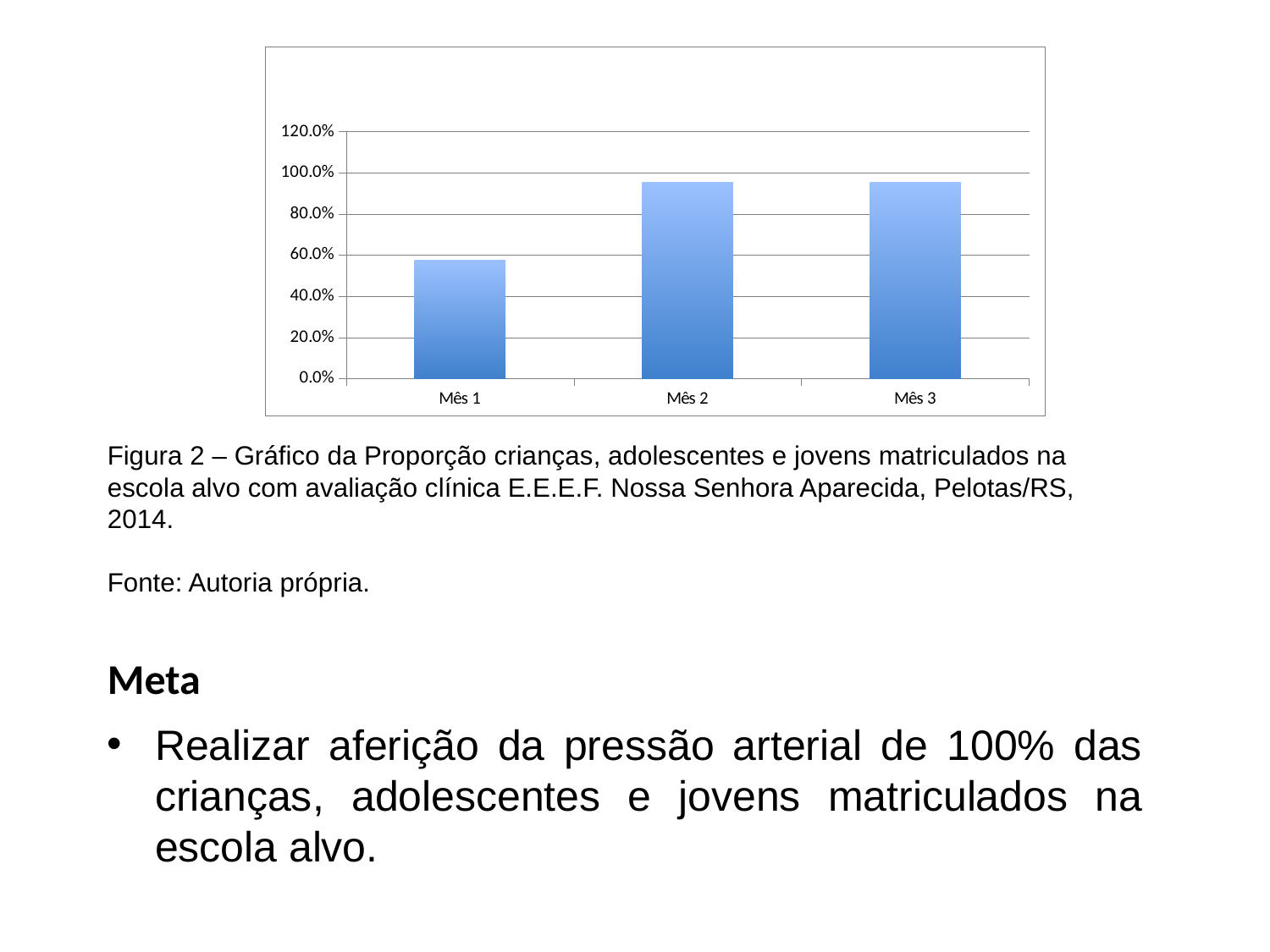
Is the value for Mês 1 greater or less than 40.0%? greater What kind of chart is shown on the slide? bar chart What is the highest value shown on the y axis of the chart? 120.0% What figure number does the caption below the chart give it? Figura 2 Is the value for Mês 1 greater or less than 80.0%? less Which is larger, the value for Mês 1 or the value for Mês 2? Mês 2 Is the value for Mês 3 greater or less than 100.0%? less How many categories (months) are plotted on the x axis of the chart? 3 Does the value rise or fall from Mês 1 to Mês 2? rise Which month has the lowest bar in the chart? Mês 1 Which is larger, the value for Mês 3 or the value for Mês 1? Mês 3